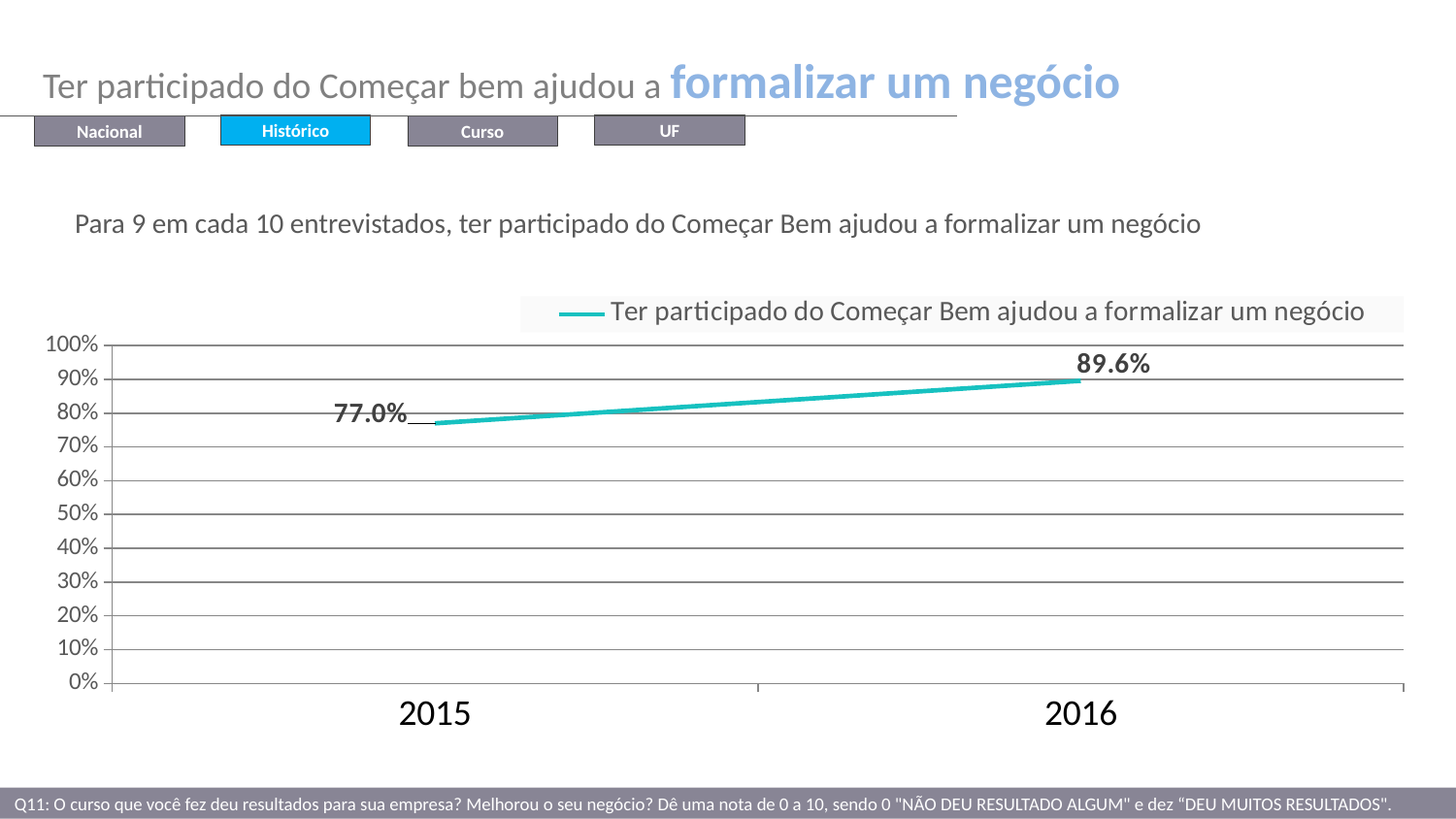
What is the value for 2016? 89.6% Which year has the lowest value? 2015 Which year has the highest value? 2016 Which is larger, the value for 2015 or the value for 2016? 2016 Do the values rise or fall from 2015 to 2016? rise What kind of chart is shown? line chart What is the difference between the 2016 and 2015 values? 12.6% How many series does the legend list? 1 What is the value for 2015? 77.0% Is the value for 2016 greater or less than 90%? less Is the value for 2015 greater or less than 70%? greater How many years are plotted on the chart? 2